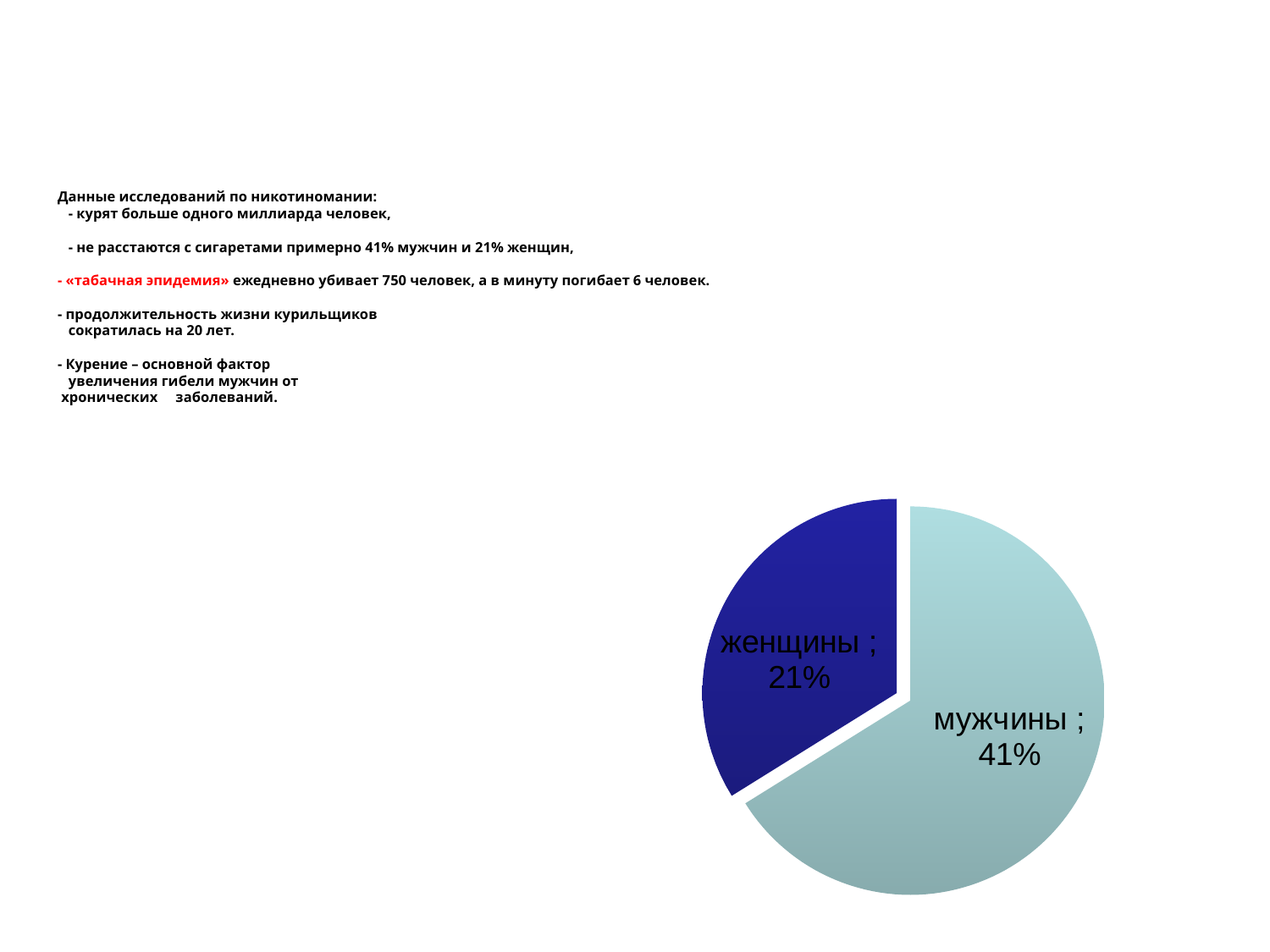
What type of chart is shown on the slide? pie chart Which category has the smallest slice in the pie chart? женщины Which category has the largest slice in the pie chart? мужчины What value is shown for the мужчины slice of the pie chart? 41% By how many percentage points does the value for мужчины exceed the value for женщины in the pie chart? 20 Which slice of the pie chart is pulled out (exploded) from the rest? женщины What colour is the женщины slice in the pie chart? dark blue Which is larger in the pie chart, the value for мужчины or the value for женщины? мужчины What value is shown for the женщины slice of the pie chart? 21% How many slices does the pie chart have? 2